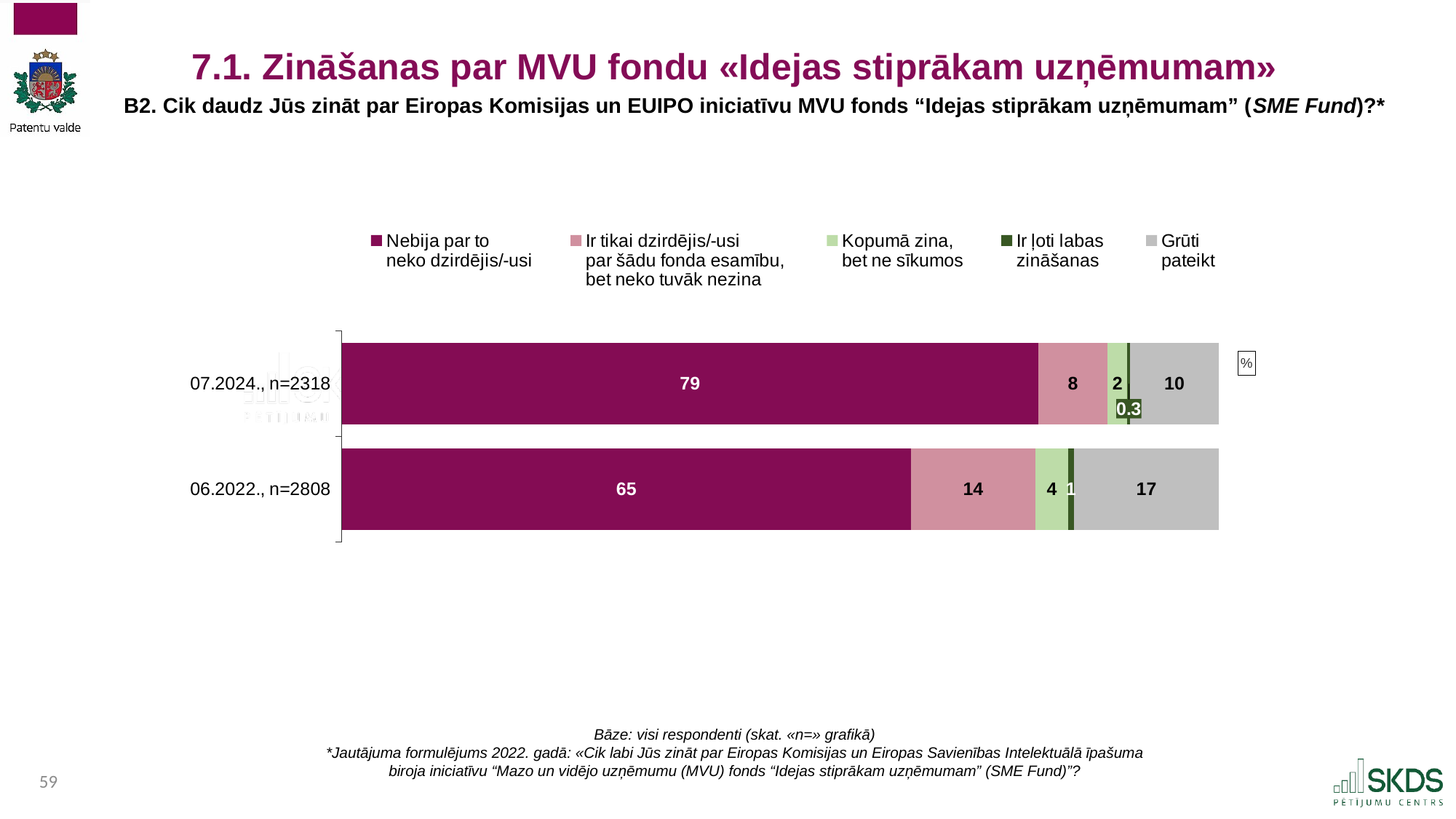
How many bars (survey waves) are shown in the chart? 2 Which survey wave has the higher value for "Grūti pateikt"? 06.2022., n=2808 How many series does the legend list? 5 What is the value for "Ir ļoti labas zināšanas" in the 07.2024., n=2318 bar? 0.3 What is the value for "Nebija par to neko dzirdējis/-usi" in the 07.2024., n=2318 bar? 79 Which segment is the smallest in the 06.2022., n=2808 bar? Ir ļoti labas zināšanas What is the value for "Grūti pateikt" in the 06.2022., n=2808 bar? 17 What is the value for "Ir tikai dzirdējis/-usi par šādu fonda esamību, bet neko tuvāk nezina" in the 06.2022., n=2808 bar? 14 What unit is indicated next to the chart? % What is the difference between the "Nebija par to neko dzirdējis/-usi" values for 07.2024. and 06.2022.? 14 What kind of chart is shown on the slide? Stacked bar chart Which survey wave has the larger value for "Kopumā zina, bet ne sīkumos": 07.2024. or 06.2022.? 06.2022.